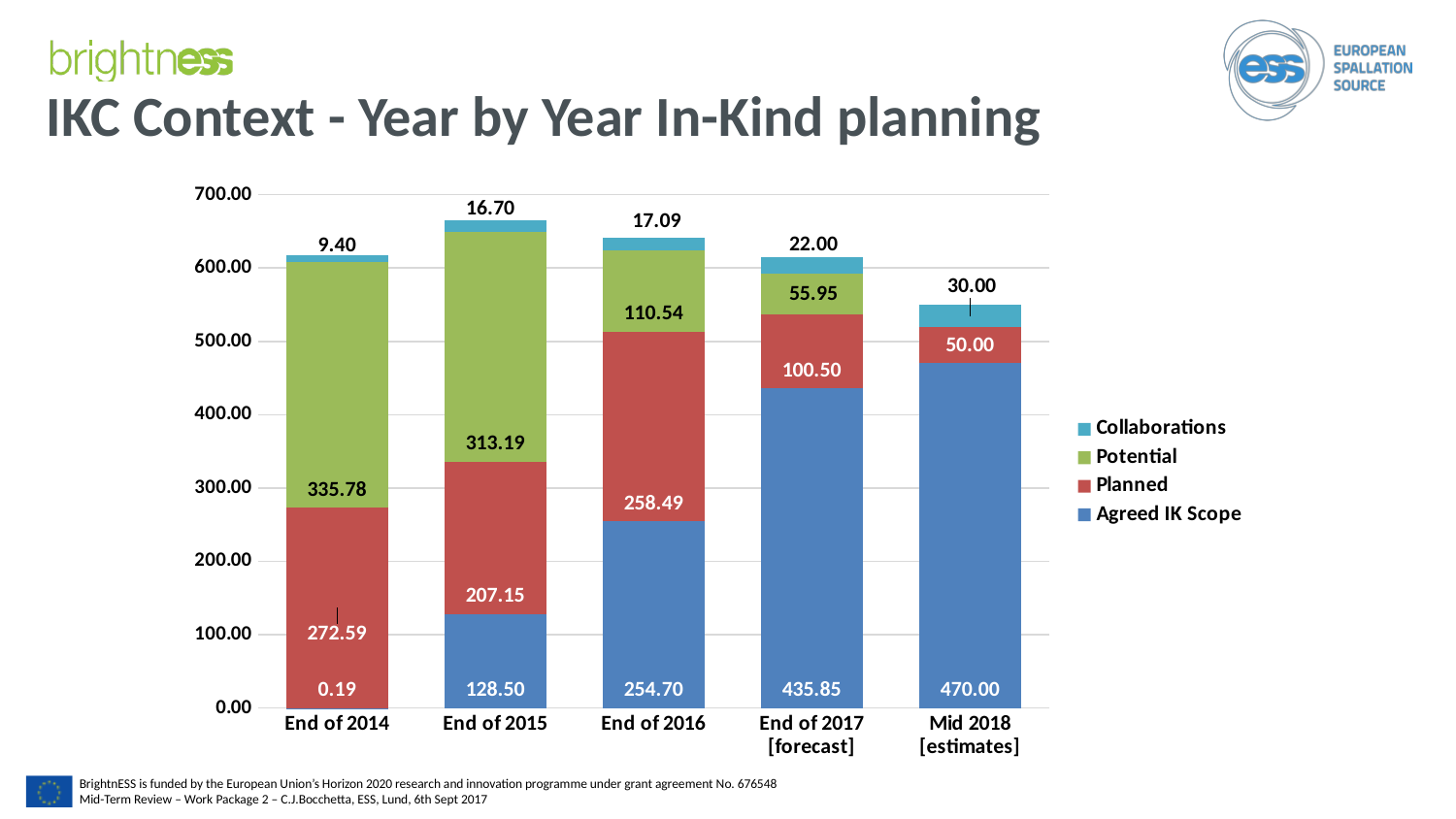
What is the Agreed IK Scope value for End of 2016? 254.70 Which period has the highest Agreed IK Scope value? Mid 2018 [estimates] How many series does the legend list? 4 Which has the larger Planned value, End of 2014 or End of 2016? End of 2014 What kind of chart is shown on the slide? Stacked bar chart Which period has the lowest Collaborations value? End of 2014 How many time periods (bars) are shown on the x axis? 5 What is the Collaborations value for End of 2017 [forecast]? 22.00 What is the Potential value for End of 2015? 313.19 What is the total of the stacked bar for End of 2014? 617.96 By how much does the Agreed IK Scope value for Mid 2018 [estimates] exceed that for End of 2017 [forecast]? 34.15 Does the Agreed IK Scope value rise or fall from End of 2014 to Mid 2018 [estimates]? Rise